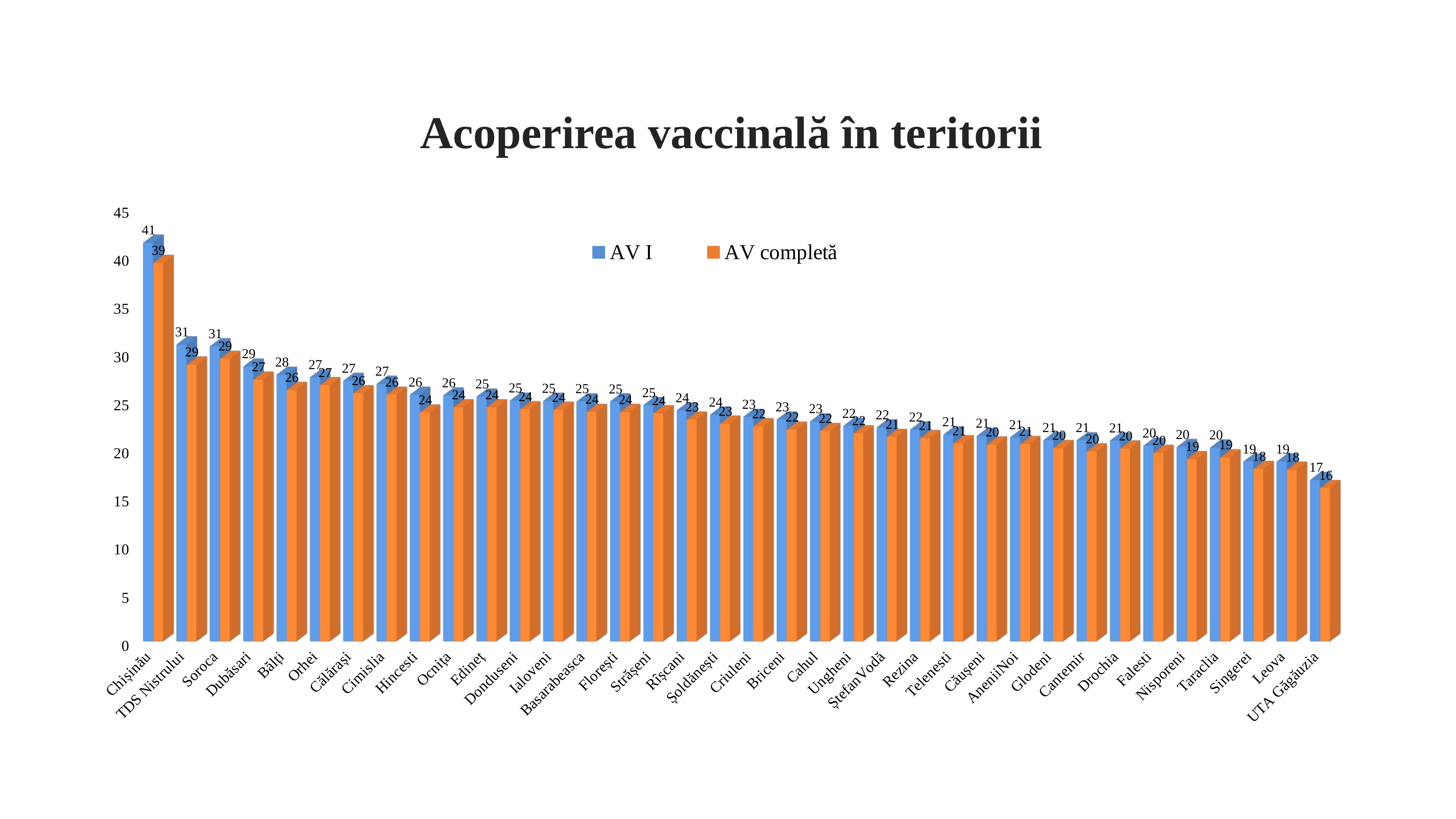
What is the difference between the AV I values for Chișinău and Soroca? 10 What is the AV I value for Chișinău? 41 Do the AV I values rise or fall from left to right along the x axis? Fall What is the AV I value for UTA Găgăuzia? 17 What is the AV completă value for Dubăsari? 27 Which is larger, the AV I value for Bălți or the AV I value for Leova? Bălți What kind of chart is shown on the slide? Bar chart What is the difference between the AV I and AV completă values for Chișinău? 2 How many series does the legend list? 2 Which territory has the highest AV completă value? Chișinău How many territories are shown on the x axis? 36 Which territory has the lowest AV I value? UTA Găgăuzia